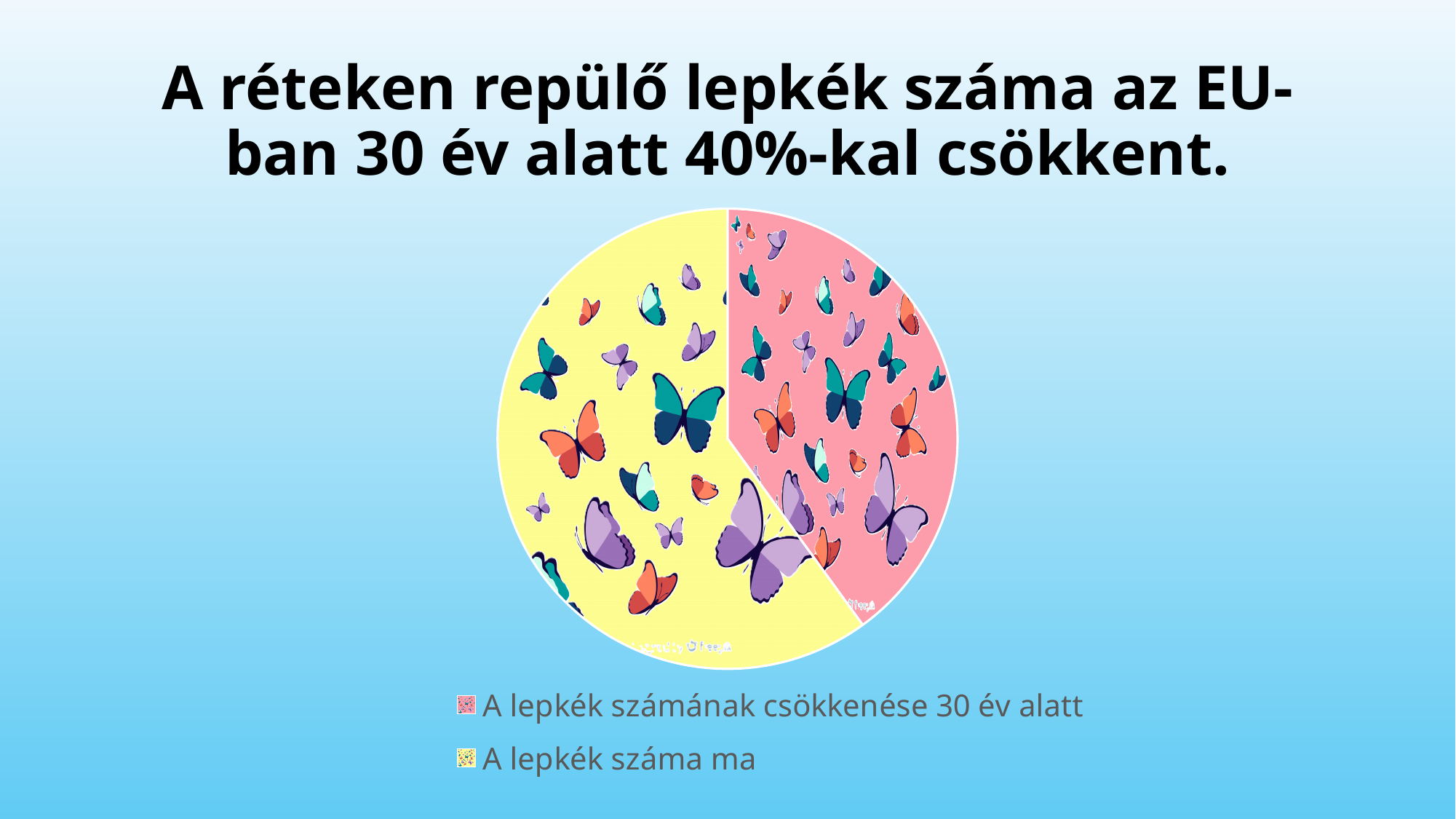
Which is larger: the slice for 'A lepkék száma ma' or the slice for 'A lepkék számának csökkenése 30 év alatt'? A lepkék száma ma Which colour represents 'A lepkék száma ma' in the pie chart? yellow How many slices does the pie chart have? 2 Which slice of the pie chart is the smallest? A lepkék számának csökkenése 30 év alatt What is the title of the slide? A réteken repülő lepkék száma az EU-ban 30 év alatt 40%-kal csökkent. Which slice of the pie chart is the largest? A lepkék száma ma How many entries does the legend list? 2 According to the slide title, what share of the pie does the slice 'A lepkék számának csökkenése 30 év alatt' represent? 40% Is the slice 'A lepkék száma ma' greater or less than half of the pie? greater What kind of chart is shown on the slide? pie chart